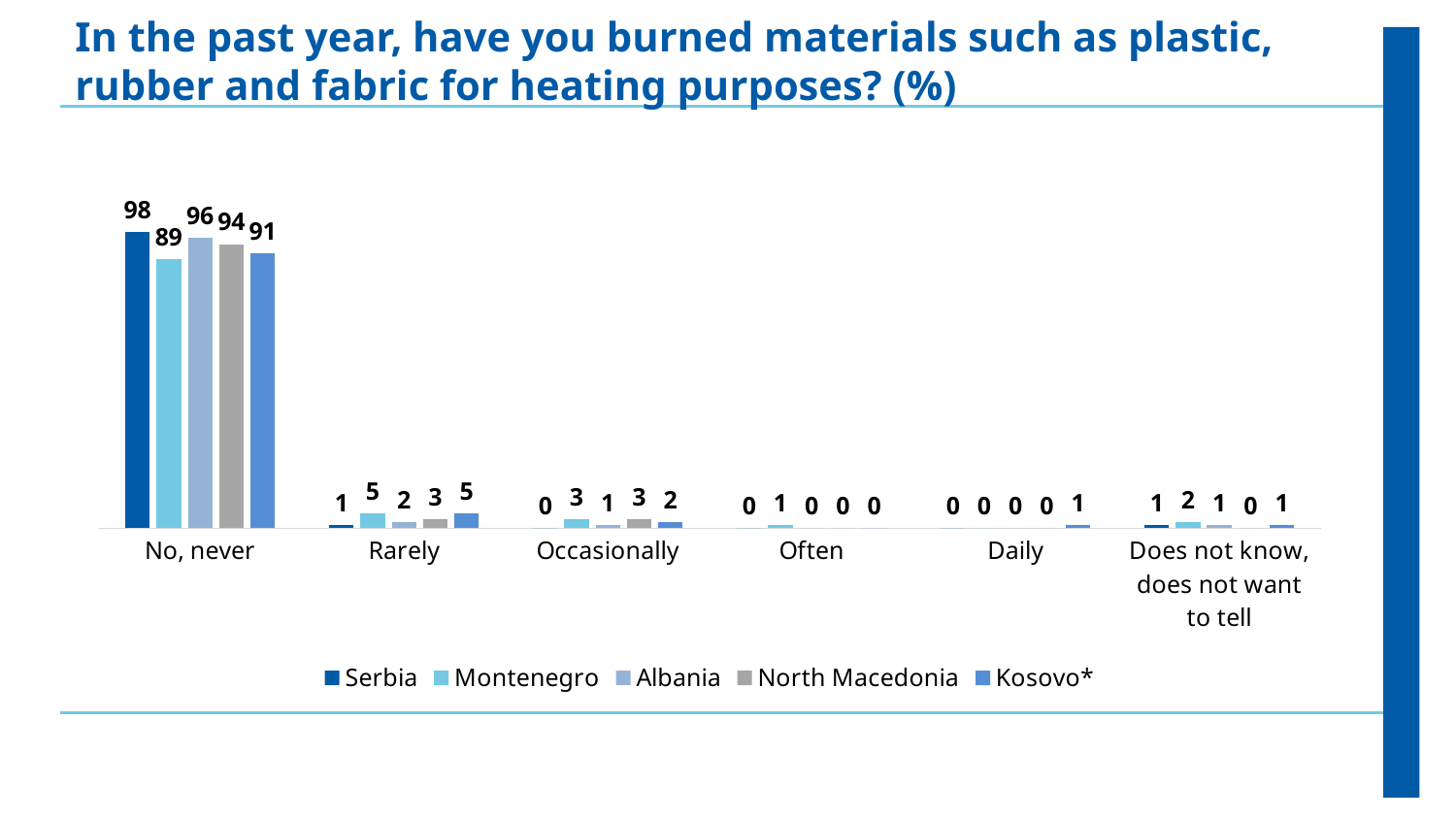
How many series does the legend list? 5 Which country is the only one with a non-zero value in the "Daily" category? Kosovo* What is the value for North Macedonia in the "Occasionally" category? 3 What kind of chart is shown on the slide? Bar chart What is the value for Serbia in the "No, never" category? 98 In the "No, never" category, which is larger: the value for Albania or the value for Kosovo*? Albania Which country has the lowest value in the "No, never" category? Montenegro Which country has the highest value in the "No, never" category? Serbia What is the value for Montenegro in the "No, never" category? 89 What is the difference between Serbia's and Montenegro's values in the "No, never" category? 9 How many response categories are shown on the x axis? 6 What is the value for Kosovo* in the "Rarely" category? 5